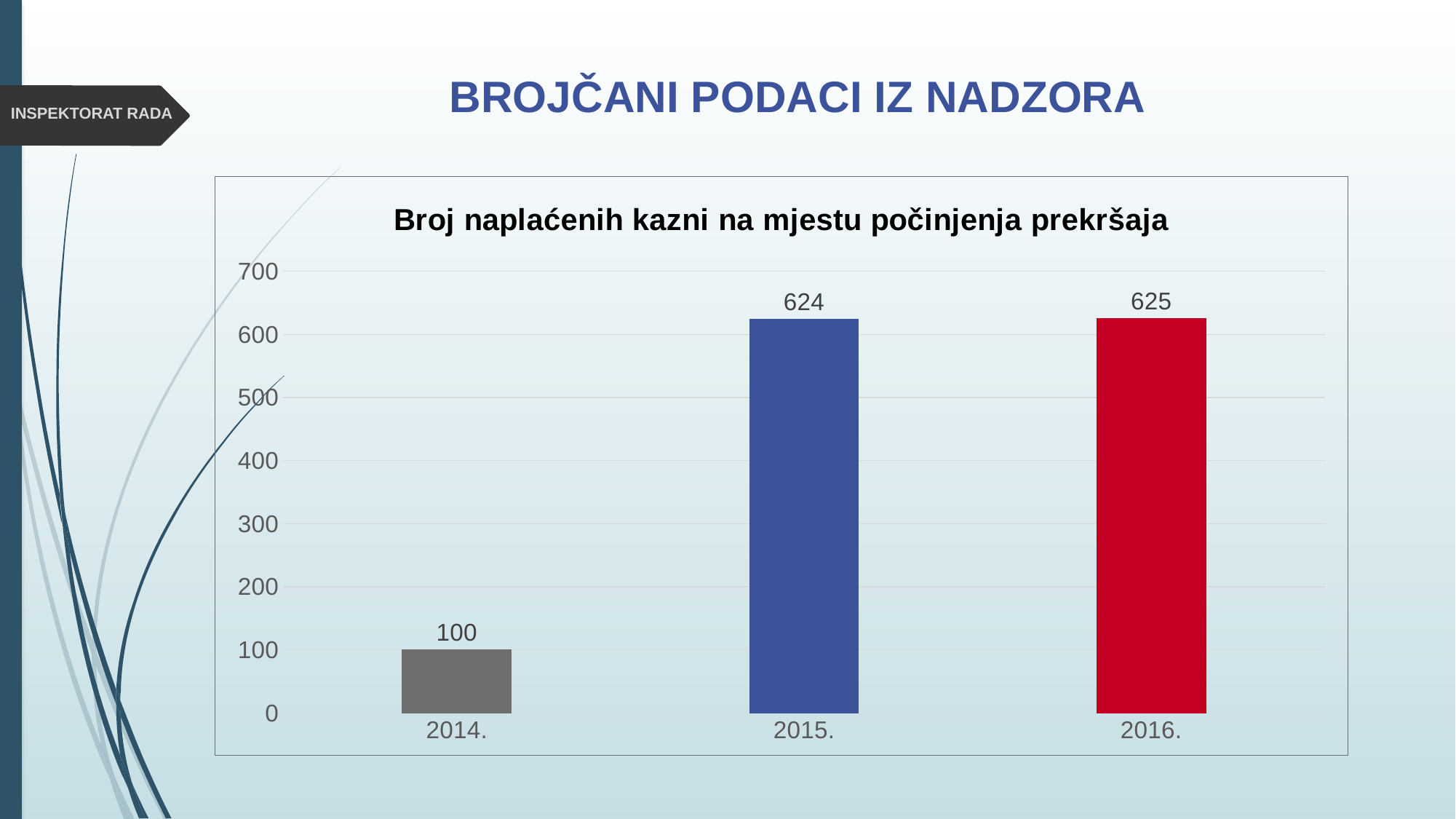
Is the value for 2014. greater or less than 200? less What is the value for 2016. in the chart? 625 What is the value for 2014. in the chart? 100 Do the values rise or fall from 2014. to 2016.? rise Which year has the lowest value in the chart? 2014. What is the value for 2015. in the chart? 624 How many years are shown on the x axis of the chart? 3 What is the difference between the values for 2015. and 2014.? 524 Is the value for 2015. greater or less than 600? greater What kind of chart is shown on the slide? bar chart What is the difference between the values for 2016. and 2015.? 1 What is the title of the chart? Broj naplaćenih kazni na mjestu počinjenja prekršaja